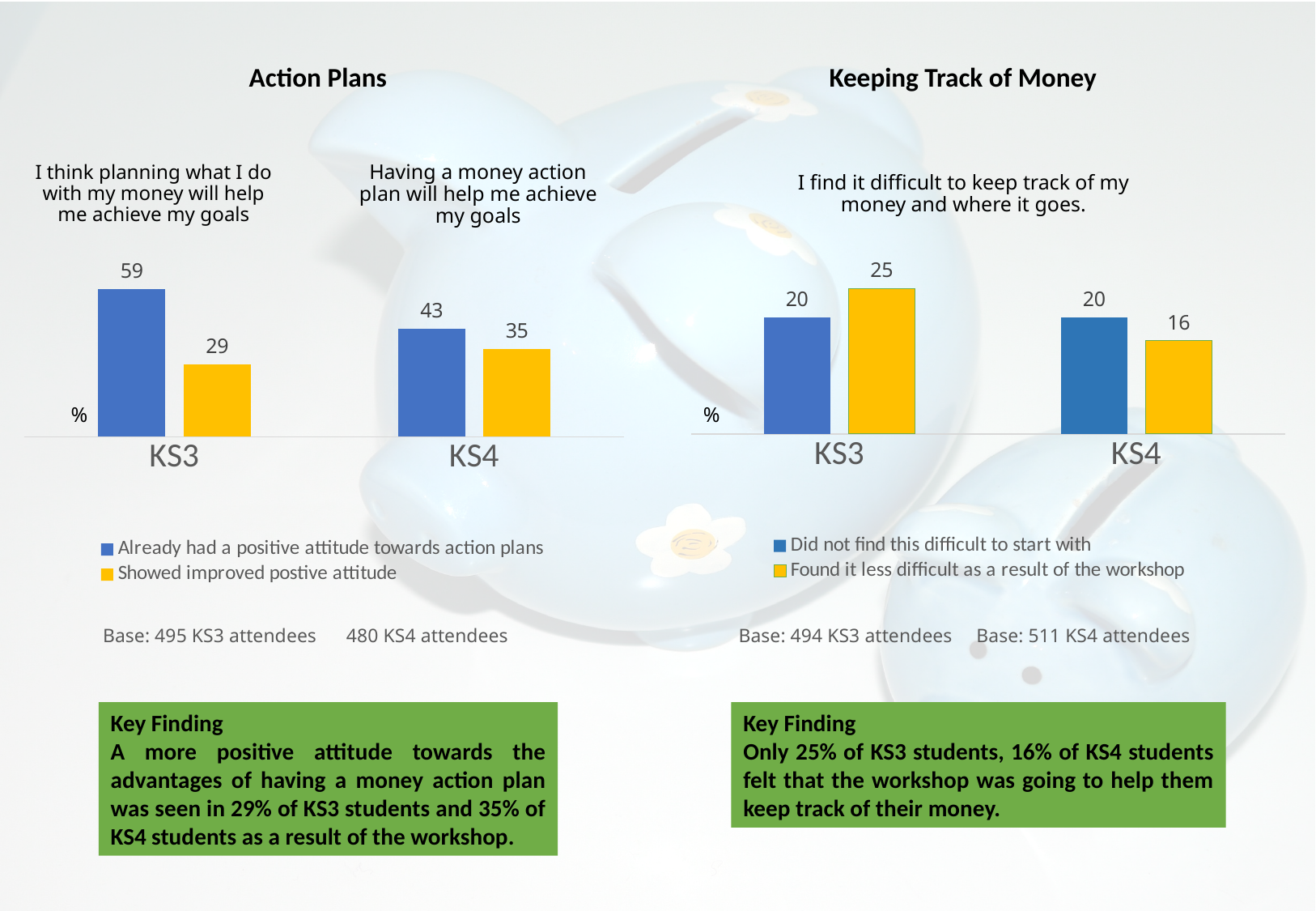
In the 'Action Plans' chart, which bar has the highest value? KS3, Already had a positive attitude towards action plans In the 'Keeping Track of Money' chart, what is the difference between the KS3 and KS4 values for 'Found it less difficult as a result of the workshop'? 9 In the 'Keeping Track of Money' chart, which bar has the lowest value? KS4, Found it less difficult as a result of the workshop In the 'Action Plans' chart, which is larger: the 'Showed improved positive attitude' value for KS3 or for KS4? KS4 In the 'Action Plans' chart, what is the value for KS3 students who already had a positive attitude towards action plans? 59 In the 'Action Plans' chart, what colour represents 'Showed improved positive attitude'? Yellow In the 'Keeping Track of Money' chart, what is the value for KS3 students who found it less difficult as a result of the workshop? 25 How many series does the legend of the 'Keeping Track of Money' chart list? 2 In the 'Action Plans' chart, what is the difference between the two KS3 bars? 30 In the 'Action Plans' chart, what is the value for KS4 students who showed improved positive attitude? 35 In the 'Keeping Track of Money' chart, what is the value for KS4 students who did not find this difficult to start with? 20 What kind of chart is the 'Action Plans' chart? Bar chart